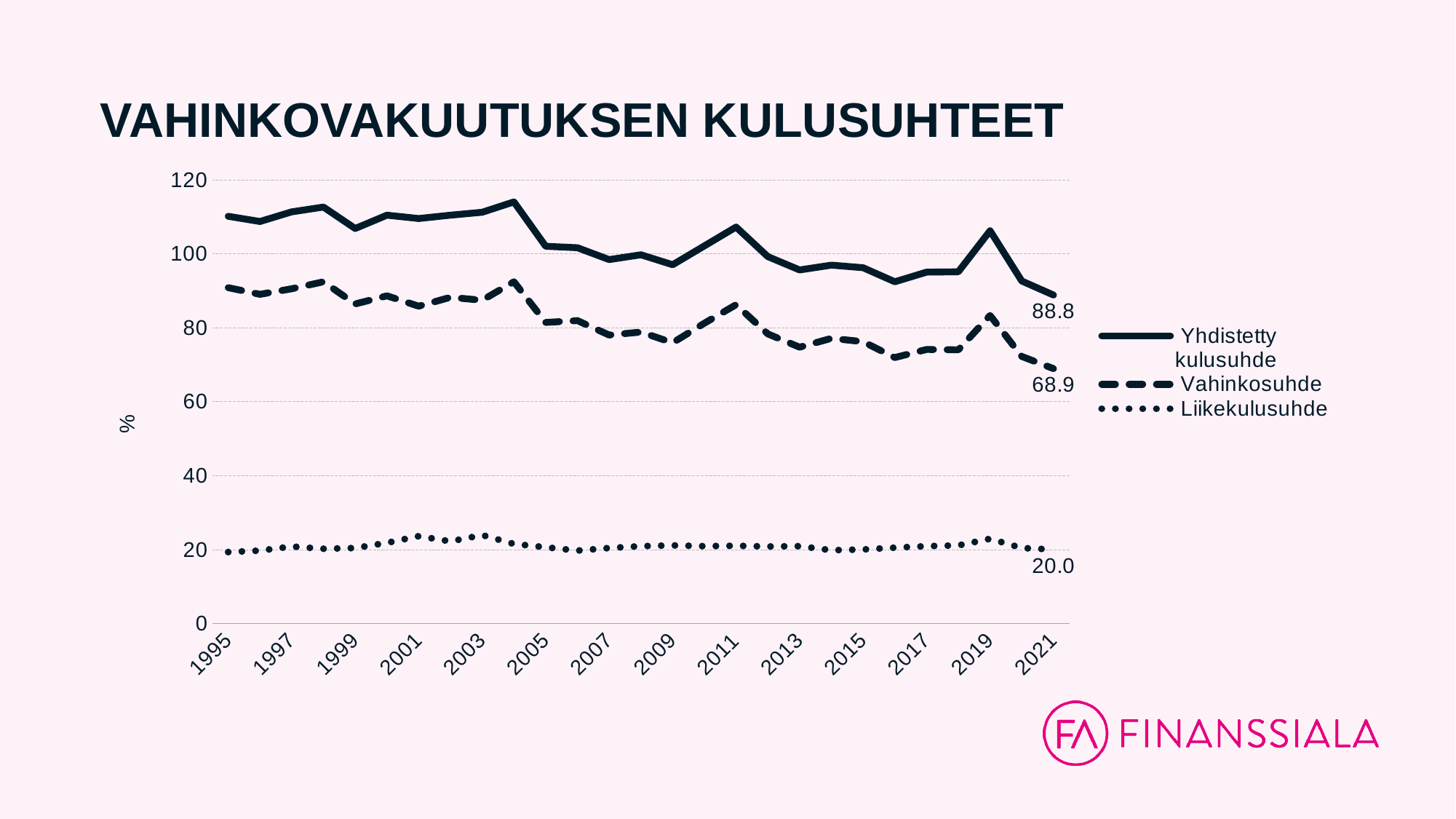
How many series does the legend list? 3 What is the value of Vahinkosuhde in 2021? 68.9 Is the value for Liikekulusuhde in 2003 greater or less than 20? greater What is the value of Yhdistetty kulusuhde in 2021? 88.8 Does Yhdistetty kulusuhde rise or fall overall from 1995 to 2021? Fall Is the value for Yhdistetty kulusuhde in 1995 greater or less than 100? greater What is the difference between Yhdistetty kulusuhde and Vahinkosuhde in 2021? 19.9 What is the value of Liikekulusuhde in 2021? 20.0 What kind of chart is shown on the slide? Line chart Is the value for Vahinkosuhde in 2019 greater or less than 80? greater What is the title of the chart? VAHINKOVAKUUTUKSEN KULUSUHTEET In 2021, which is larger: Vahinkosuhde or Liikekulusuhde? Vahinkosuhde